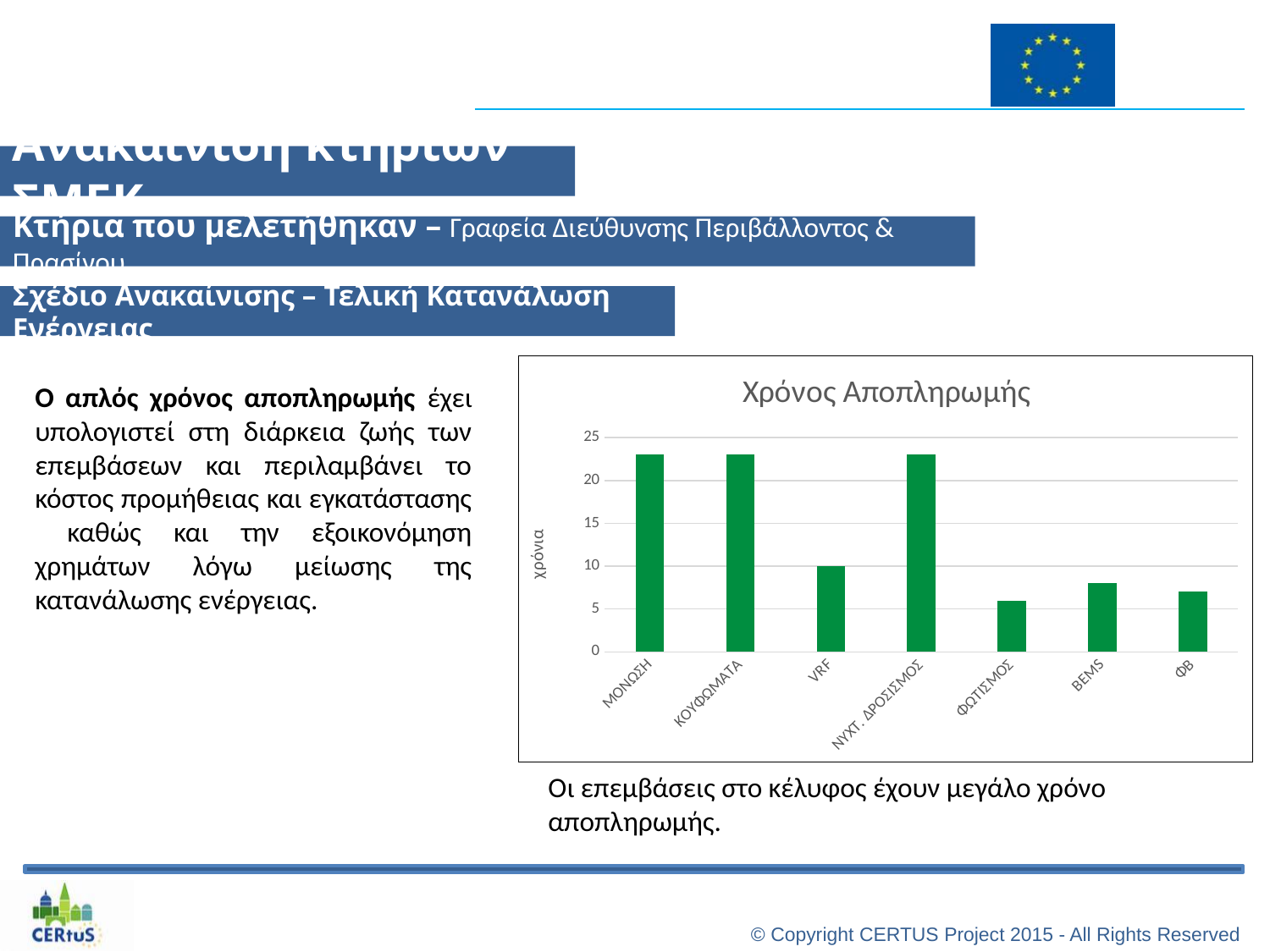
What is the label of the vertical axis of the chart? χρόνια What is the title of the chart? Χρόνος Αποπληρωμής What is the value for VRF in the chart? 10 Is the value for ΚΟΥΦΩΜΑΤΑ greater or less than 20? greater Is the value for BEMS greater or less than 5? greater What kind of chart is shown on the slide? bar chart Is the value for ΜΟΝΩΣΗ greater or less than 20? greater Which has the larger value, ΜΟΝΩΣΗ or VRF? ΜΟΝΩΣΗ Which has the larger value, VRF or ΦΒ? VRF How many categories are shown on the x axis of the chart? 7